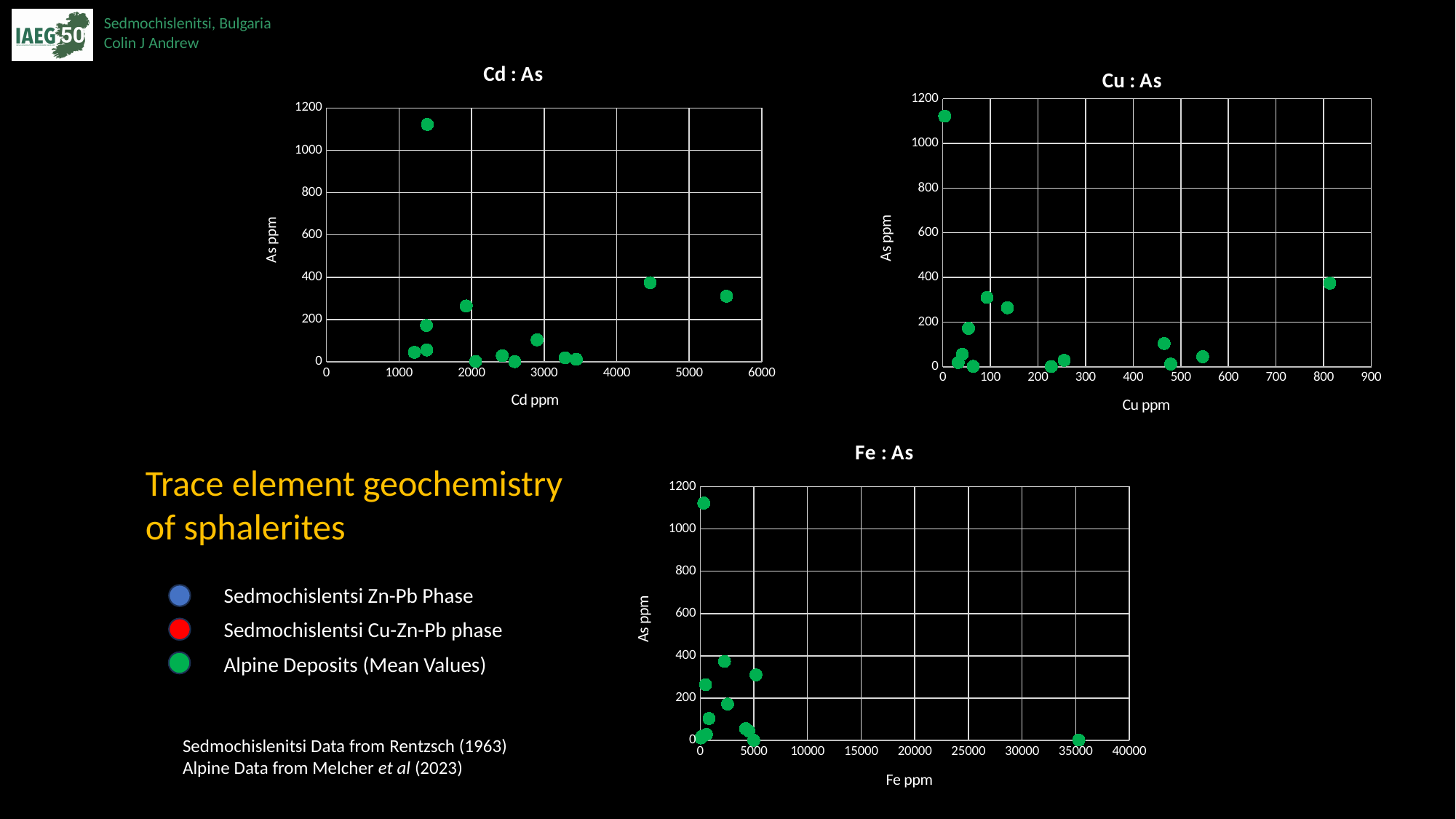
On the 'Cu : As' chart, is the As ppm value of the rightmost point greater or less than 600? less On the 'Fe : As' chart, is the As ppm value of the highest point greater or less than 1000? greater How many entries does the legend on the slide list? 3 On the 'Cu : As' chart, what is the label of the y axis? As ppm On the 'Fe : As' chart, is the Fe ppm value of the rightmost point greater or less than 30000? greater What is the maximum value shown on the y axis of the 'Cu : As' chart? 1200 What is the maximum value shown on the x axis of the 'Fe : As' chart? 40000 What kind of chart is the 'Cd : As' chart? scatter chart On the 'Cd : As' chart, what is the label of the x axis? Cd ppm